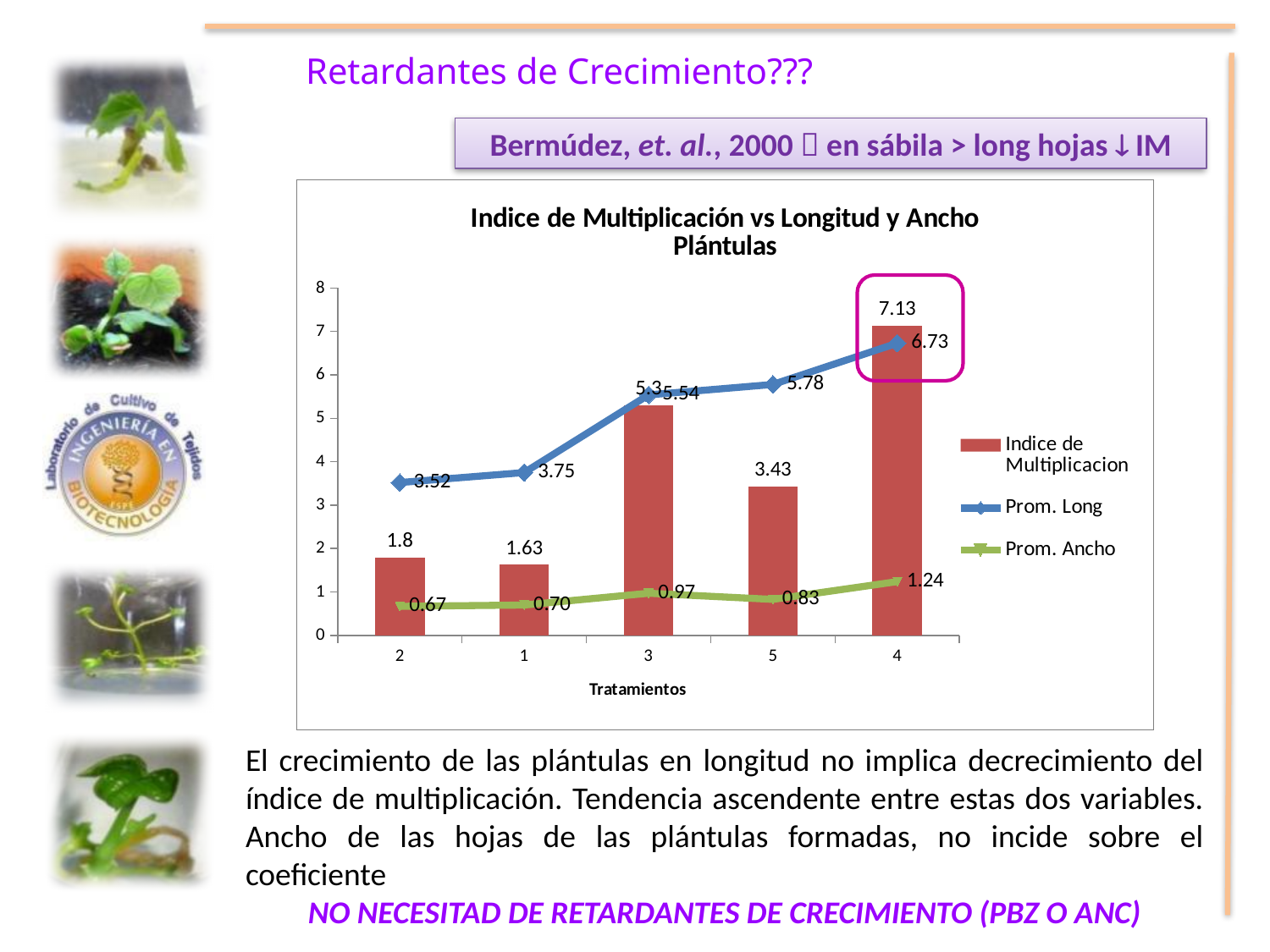
What is the Indice de Multiplicacion value for tratamiento 4? 7.13 Is the Indice de Multiplicacion for tratamiento 3 greater or less than 5? greater What is the Prom. Long value for tratamiento 2? 3.52 Which tratamiento has the lowest Indice de Multiplicacion? 1 How many tratamientos are shown on the x axis? 5 Does the Prom. Long series rise or fall from left to right along the x axis? Rises What is the Prom. Ancho value for tratamiento 5? 0.83 What kind of chart is shown on the slide? Combined bar and line chart What is the difference between the Indice de Multiplicacion for tratamiento 4 and tratamiento 5? 3.7 Which is larger: the Prom. Long value for tratamiento 3 or for tratamiento 1? Tratamiento 3 How many series does the legend list? 3 Which tratamiento has the highest Indice de Multiplicacion? 4